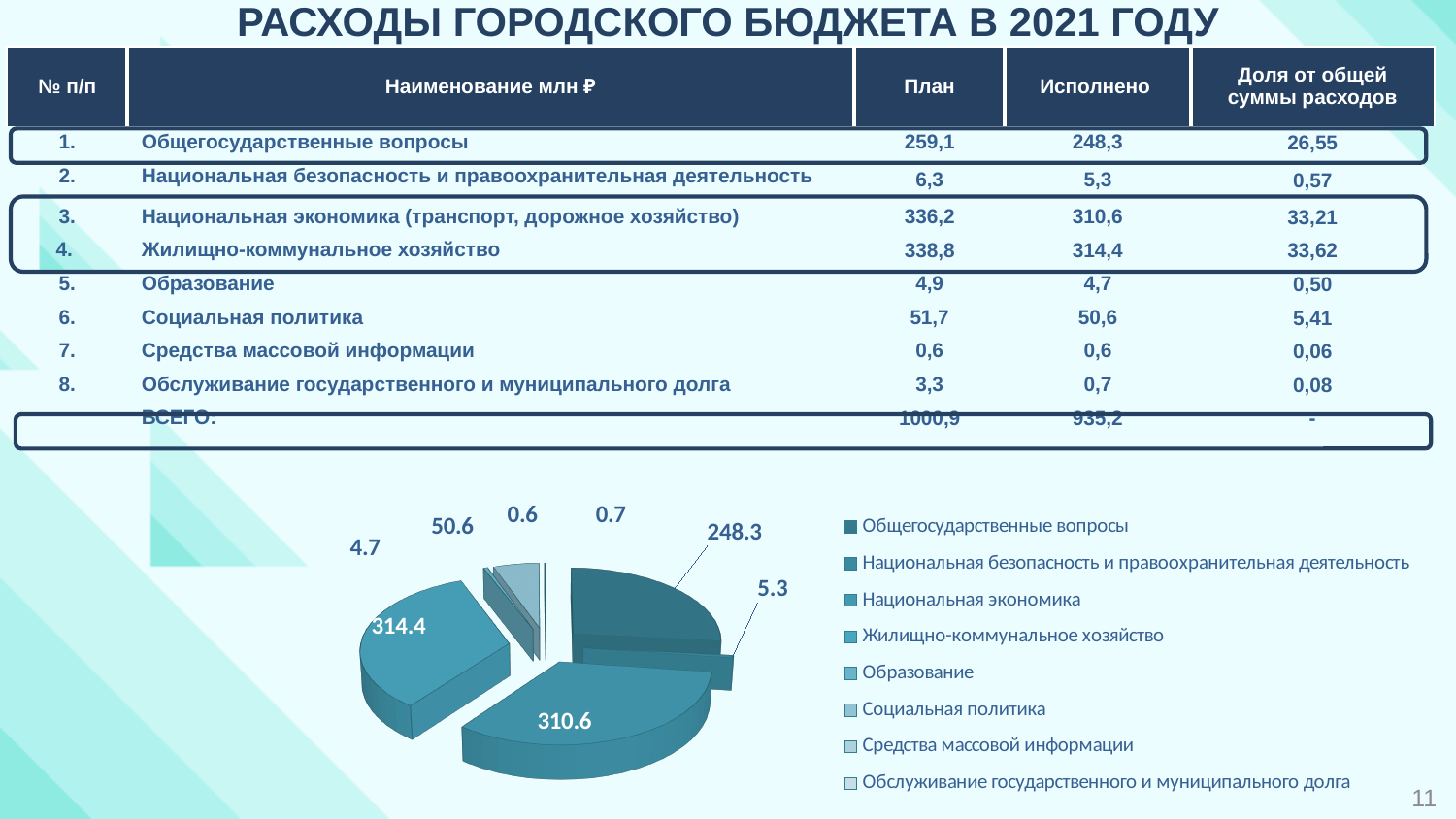
In the pie chart, which is larger: Социальная политика or Образование? Социальная политика In the pie chart, what is the difference between the values for Жилищно-коммунальное хозяйство and Национальная экономика? 3.8 In the pie chart, what is the value for Общегосударственные вопросы? 248.3 In the pie chart, what is the value for Жилищно-коммунальное хозяйство? 314.4 What kind of chart is shown at the bottom of the slide? Pie chart How many entries does the pie chart's legend list? 8 In the pie chart, what is the value for Национальная экономика? 310.6 Which category has the largest slice in the pie chart? Жилищно-коммунальное хозяйство How many slices does the pie chart have? 8 Which category has the smallest slice in the pie chart? Средства массовой информации In the pie chart, what is the difference between the values for Общегосударственные вопросы and Социальная политика? 197.7 In the pie chart, what is the value for Национальная безопасность и правоохранительная деятельность? 5.3